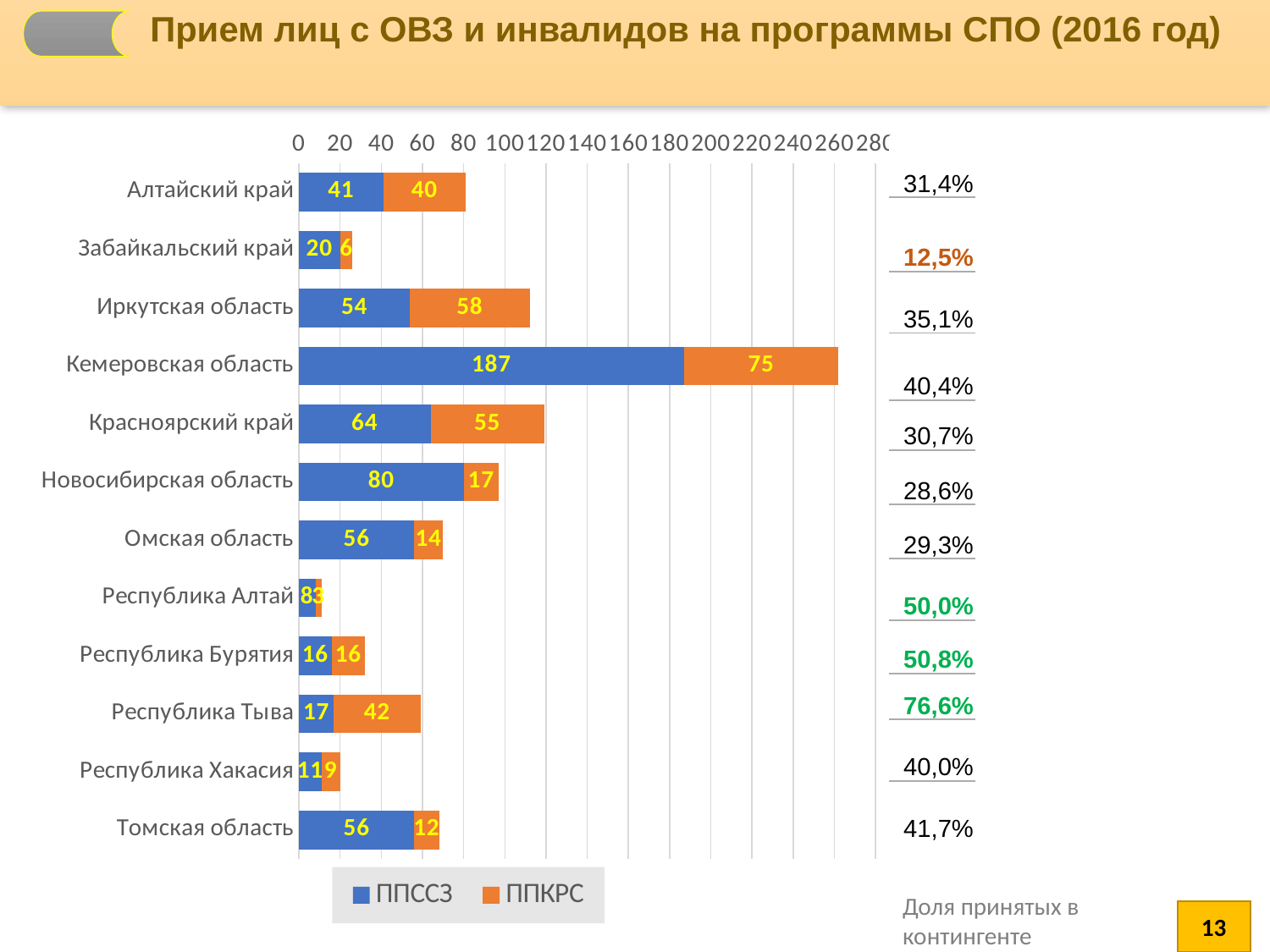
What is the total of the stacked bar for Иркутская область? 112 What kind of chart is shown on the slide? Stacked bar chart Which region has the highest ППССЗ value? Кемеровская область What is the ППССЗ value for Новосибирская область? 80 What is the ППССЗ value for Кемеровская область? 187 Which is larger for Томская область: the ППССЗ value or the ППКРС value? ППССЗ How many series does the legend list? 2 Is the total stacked bar for Кемеровская область greater or less than 240? greater How many regions (categories) are plotted in the chart? 12 What is the ППКРС value for Республика Тыва? 42 Which region has the highest ППКРС value? Кемеровская область What is the difference between the ППССЗ and ППКРС values for Красноярский край? 9